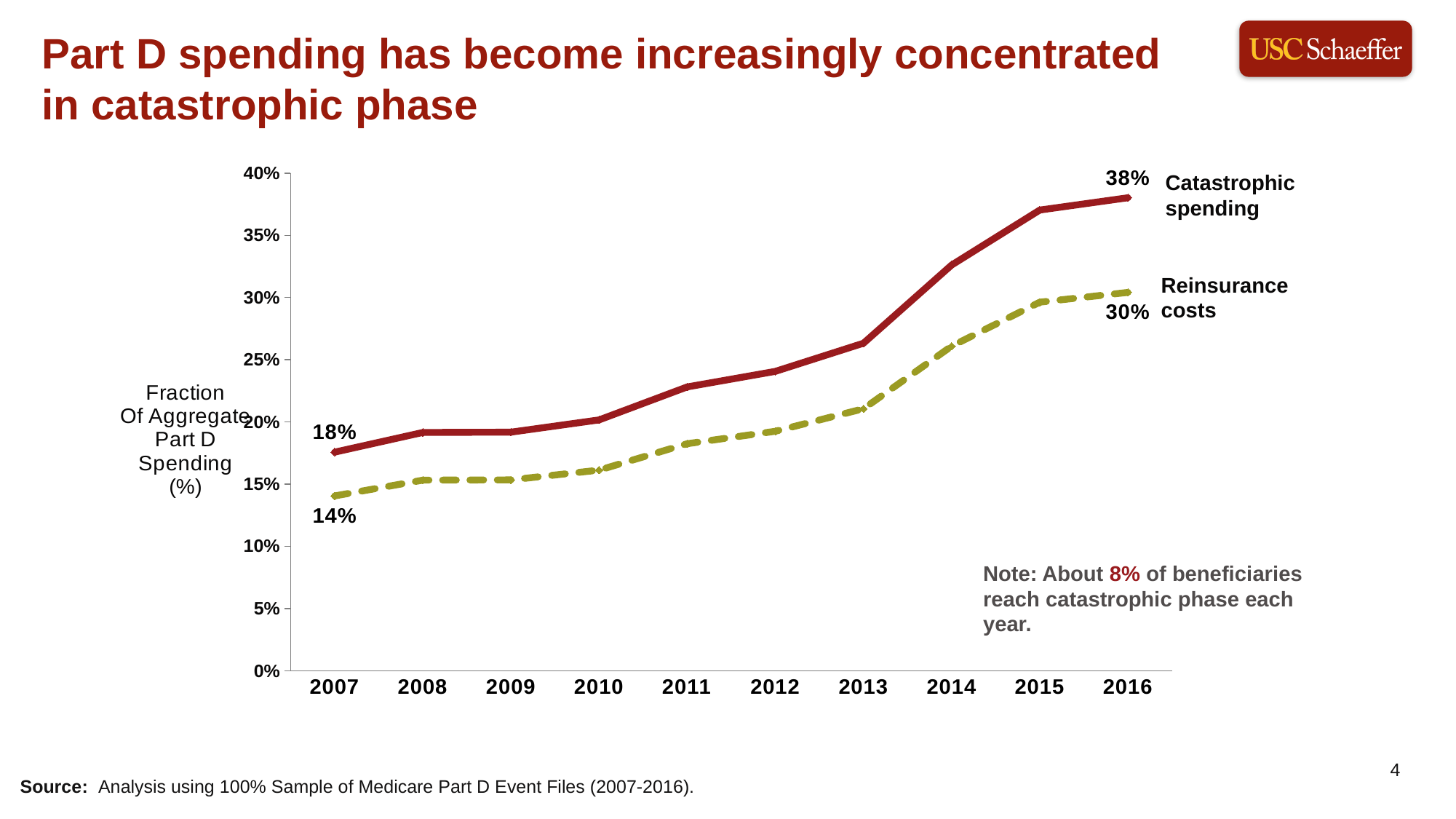
What is the value for Catastrophic spending in 2016? 38% Is the value for Reinsurance costs in 2010 greater or less than 20%? less What is the value for Reinsurance costs in 2007? 14% What is the value for Reinsurance costs in 2016? 30% Is the value for Catastrophic spending in 2014 greater or less than 30%? greater Which series has the higher value in 2016, Catastrophic spending or Reinsurance costs? Catastrophic spending How many years are shown on the x axis? 10 How many series are plotted on the chart? 2 By how many percentage points did Catastrophic spending increase from 2007 to 2016? 20 percentage points What is the value for Catastrophic spending in 2007? 18% By how many percentage points does Catastrophic spending exceed Reinsurance costs in 2016? 8 percentage points What kind of chart is shown on the slide? Line chart